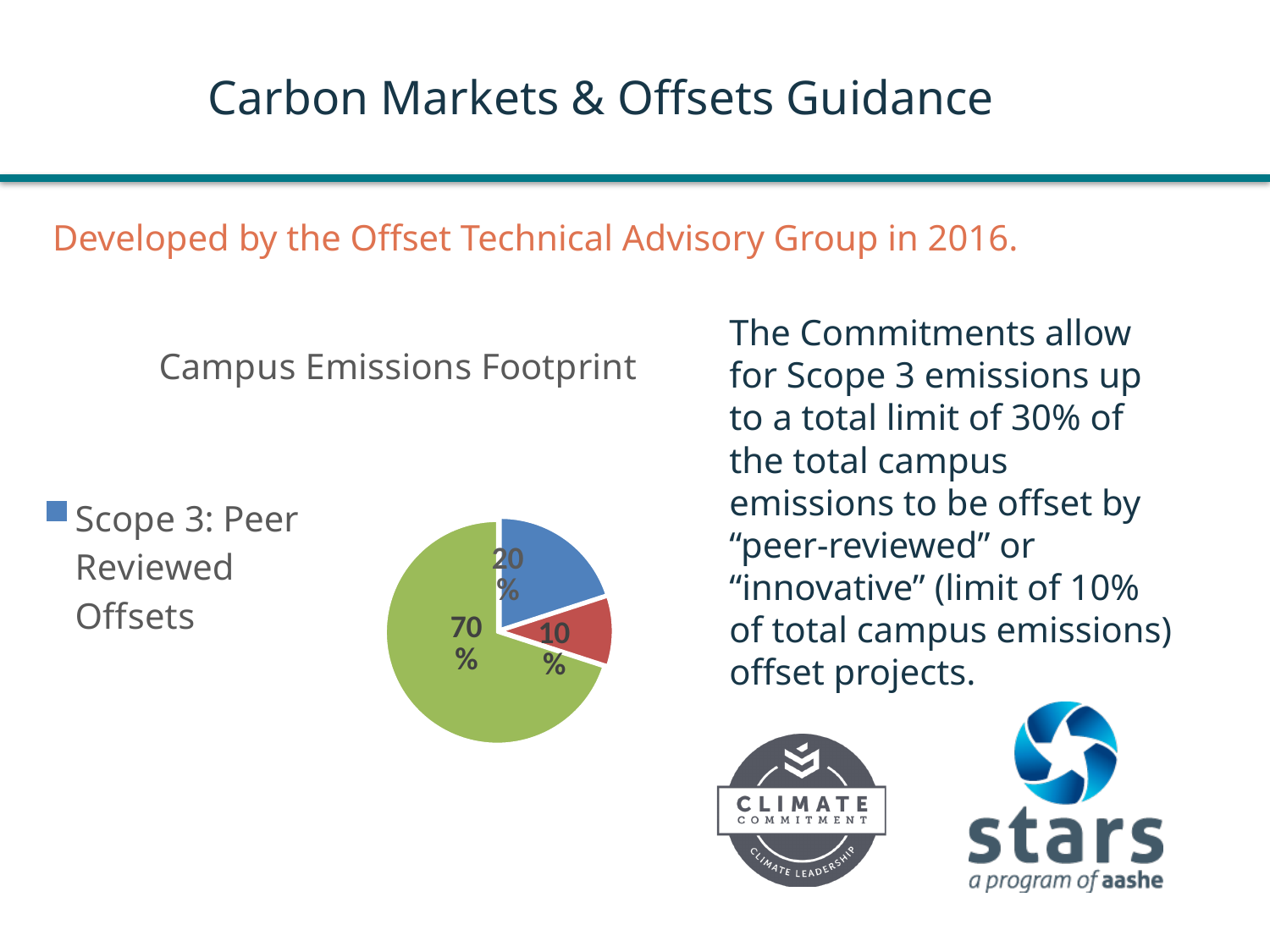
What is the difference between the largest slice (70%) and the smallest slice (10%) in the pie chart? 60% What percentage does the Scope 3: Peer Reviewed Offsets slice represent in the pie chart? 20% What is the difference between the Scope 3: Peer Reviewed Offsets slice and the 10% slice in the pie chart? 10% What kind of chart is shown under the title "Campus Emissions Footprint"? Pie chart Which is larger in the pie chart: the Scope 3: Peer Reviewed Offsets slice or the red slice? Scope 3: Peer Reviewed Offsets What share of the pie does the green slice represent? 70% How many slices does the Campus Emissions Footprint pie chart have? 3 What is the value of the largest slice in the Campus Emissions Footprint pie chart? 70% What is the value of the smallest slice in the Campus Emissions Footprint pie chart? 10% What is the title of the chart on the slide? Campus Emissions Footprint Is the Scope 3: Peer Reviewed Offsets slice greater or less than 50% of the pie? less What colour is the largest slice of the Campus Emissions Footprint pie chart? Green